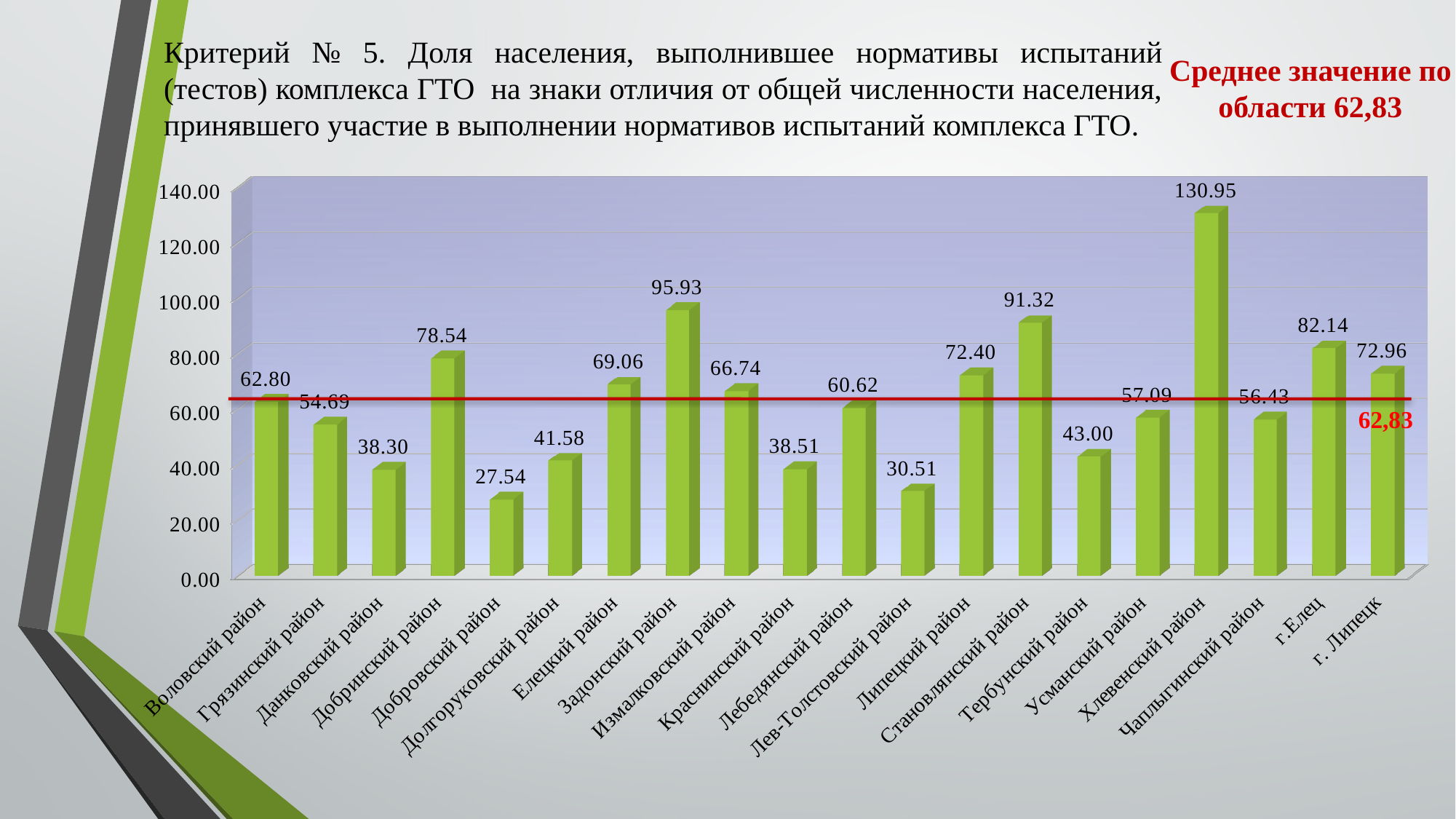
What kind of chart is shown on the slide? bar chart What is the value for Задонский район? 95.93 What is the value for г. Липецк? 72.96 What value does the red horizontal line on the chart mark? 62,83 Which district has the lowest value? Добровский район Is the value for Лев-Толстовский район greater or less than 40.00? less Which district has the highest value? Хлевенский район What is the difference between the values for Становлянский район and Тербунский район? 48.32 What is the value for Данковский район? 38.30 What is the value for Хлевенский район? 130.95 Which is larger, the value for Добринский район or the value for Елецкий район? Добринский район How many districts/cities are shown on the x axis? 20